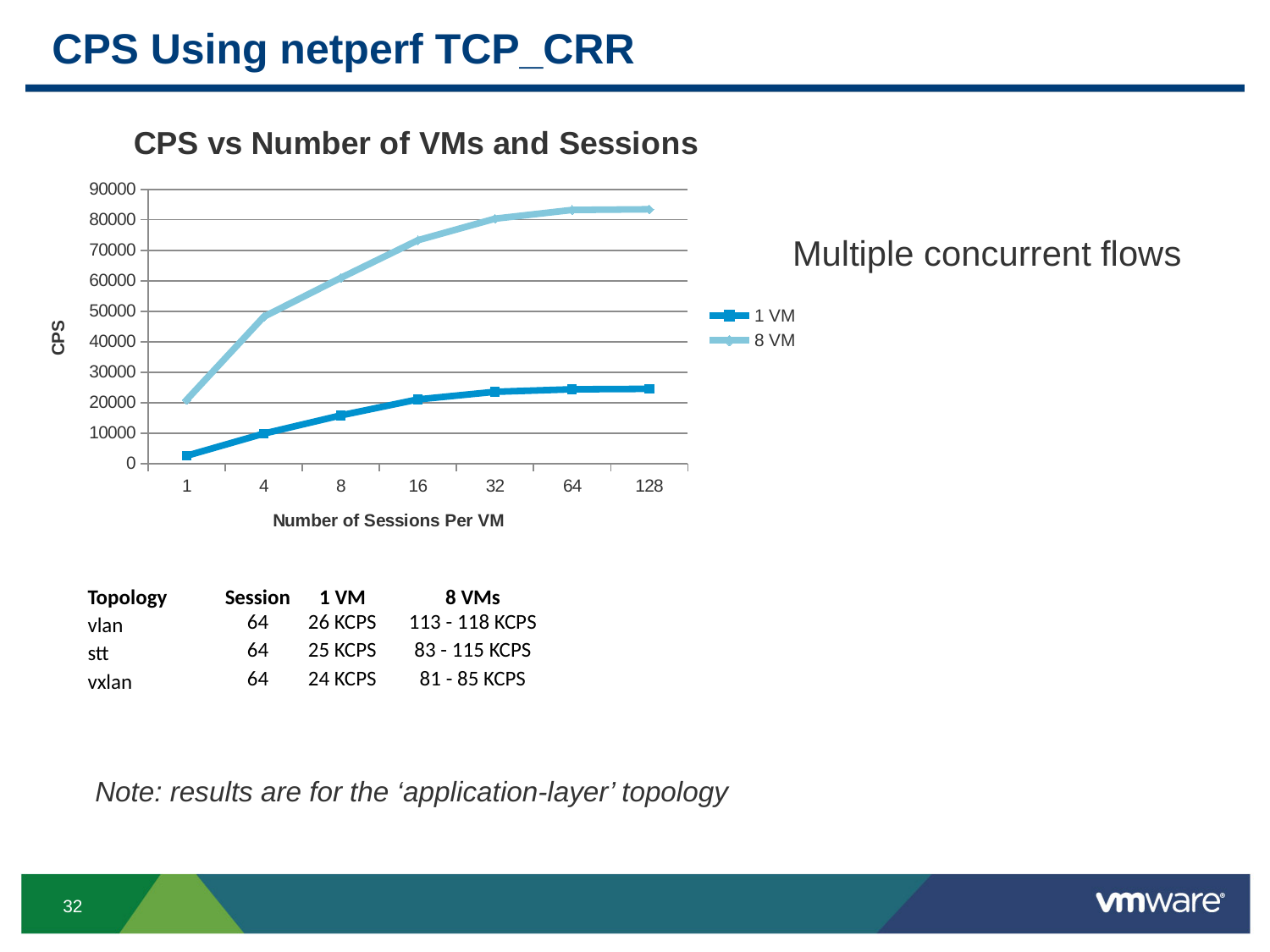
Is the CPS value for 1 VM at 8 sessions per VM greater or less than 20000? less How many series does the chart legend list? 2 At which number of sessions per VM is the CPS for the 1 VM series lowest? 1 Is the CPS value for 8 VM at 128 sessions per VM greater or less than 80000? greater How many x-axis categories (numbers of sessions per VM) are plotted on the chart? 7 What kind of chart is shown on the slide? line chart Is the CPS value for 8 VM at 16 sessions per VM greater or less than 70000? greater Do the CPS values for the 8 VM series rise or fall as the number of sessions per VM increases? rise What is the title of the chart? CPS vs Number of VMs and Sessions At 32 sessions per VM, which series has the higher CPS, 1 VM or 8 VM? 8 VM